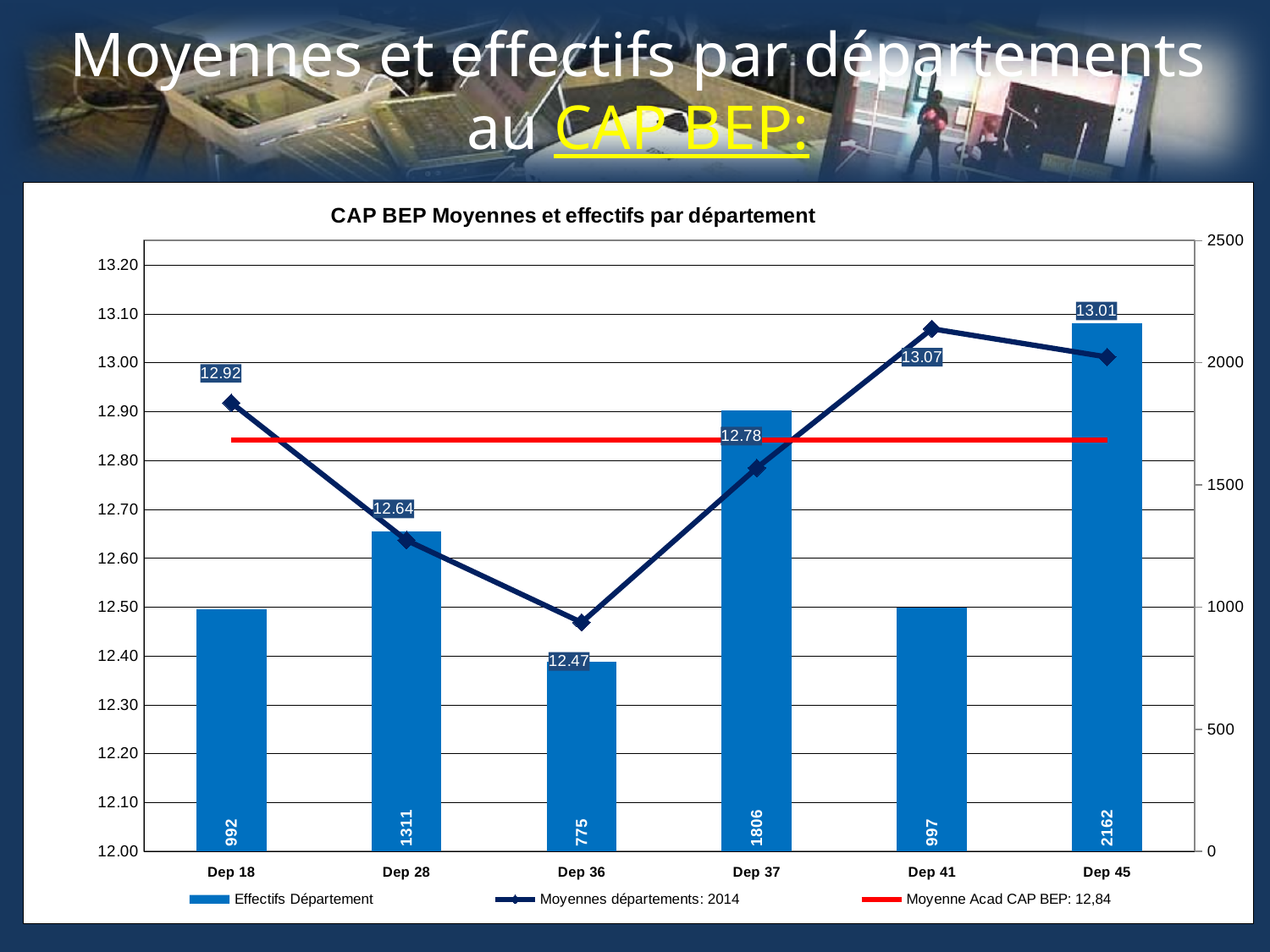
Which has a higher Moyennes départements: 2014 value, Dep 41 or Dep 45? Dep 41 What is the title of the chart? CAP BEP Moyennes et effectifs par département Which department has the highest Effectifs Département value? Dep 45 What is the Effectifs Département value for Dep 37? 1806 What is the Moyennes départements: 2014 value for Dep 36? 12.47 Which department has the lowest Moyennes départements: 2014 value? Dep 36 What is the difference in Effectifs Département between Dep 45 and Dep 18? 1170 How many departments are shown on the x axis? 6 Is the Effectifs Département value for Dep 28 greater or less than 1500? less What kind of chart is this? Combined bar and line chart What value does the legend give for the Moyenne Acad CAP BEP line? 12,84 How many series does the legend list? 3